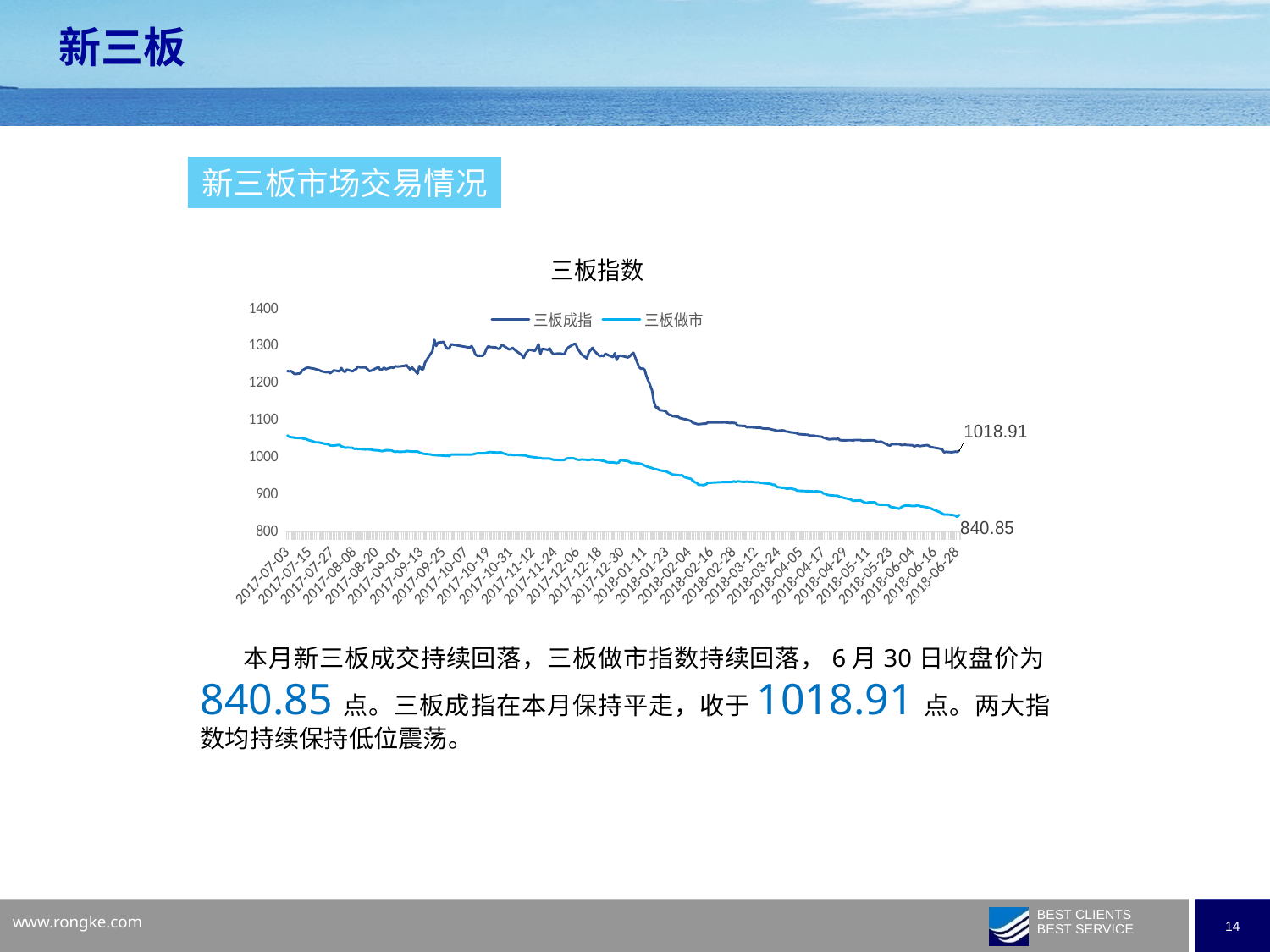
Does the 三板成指 series generally rise or fall from 2018-01-11 to 2018-06-28? fall Is the value of 三板做市 around 2018-06-28 greater or less than 900? less Which series ends at a higher value, 三板成指 or 三板做市? 三板成指 What type of chart is shown on the slide? line chart Does the 三板做市 series generally rise or fall from 2017-07-03 to 2018-06-28? fall What is the title of the chart? 三板指数 How many series does the chart legend list? 2 Is the value of 三板成指 around 2017-10-07 greater or less than 1200? greater What is the final labelled value of the 三板做市 series at the end of the chart? 840.85 What is the final labelled value of the 三板成指 series at the end of the chart? 1018.91 What are the two series named in the chart legend? 三板成指 and 三板做市 What is the difference between the final labelled values of 三板成指 (1018.91) and 三板做市 (840.85)? 178.06